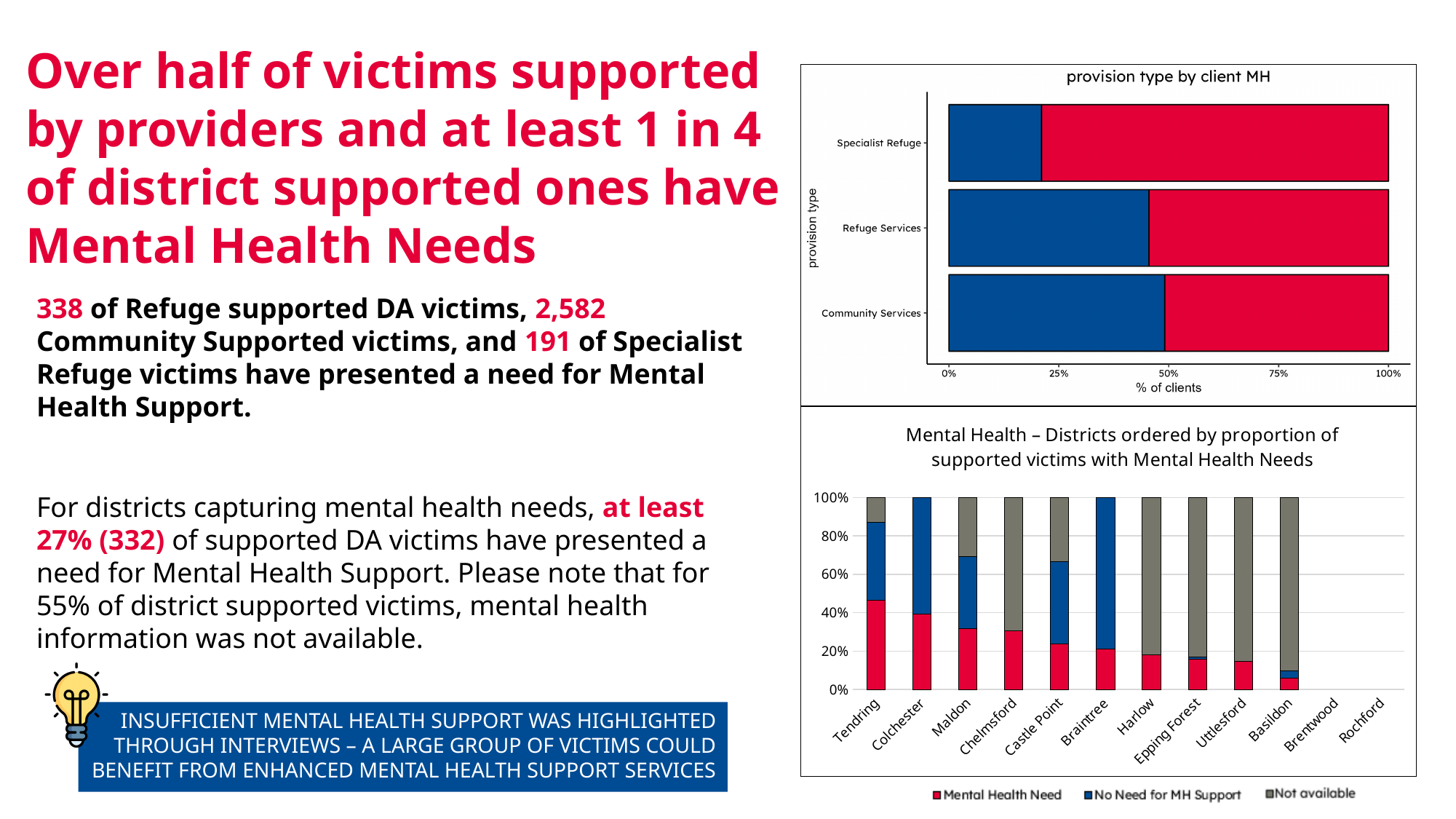
What kind of chart is the 'provision type by client MH' chart? bar chart In the 'provision type by client MH' chart, is the blue portion for Refuge Services greater or less than 50%? less In the 'Mental Health – Districts' chart, which has the larger Mental Health Need proportion, Tendring or Colchester? Tendring How many districts are shown on the x axis of the 'Mental Health – Districts ordered by proportion of supported victims with Mental Health Needs' chart? 12 In the 'Mental Health – Districts' chart, is the Mental Health Need value for Tendring greater or less than 40%? greater In the 'Mental Health – Districts' chart, is the Mental Health Need value for Basildon greater or less than 20%? less How many provision types are shown in the 'provision type by client MH' chart? 3 How many series does the legend list in the 'Mental Health – Districts ordered by proportion of supported victims with Mental Health Needs' chart? 3 What is the x-axis label of the 'provision type by client MH' chart? % of clients In the 'Mental Health – Districts' chart, does the Mental Health Need proportion rise or fall from left to right along the x axis? fall In the 'Mental Health – Districts' chart, which district has the highest Mental Health Need proportion? Tendring